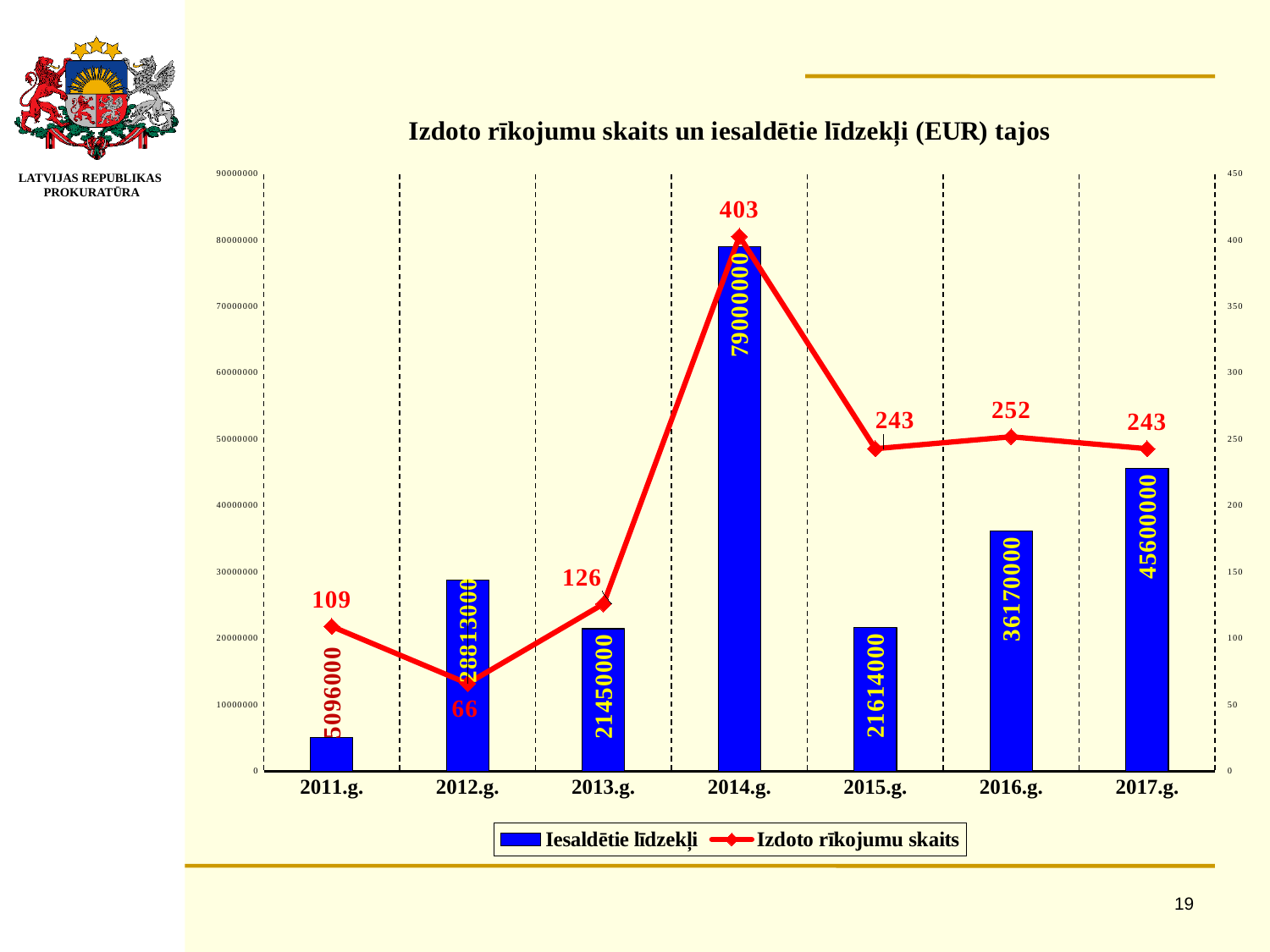
What is the difference between the Iesaldētie līdzekļi values for 2017.g. and 2016.g.? 9430000 What is the Izdoto rīkojumu skaits value for 2017.g.? 243 What is the Izdoto rīkojumu skaits value for 2011.g.? 109 What is the difference between the Izdoto rīkojumu skaits values for 2016.g. and 2015.g.? 9 Which year has the highest Iesaldētie līdzekļi value? 2014.g. Is the Iesaldētie līdzekļi value for 2012.g. greater or less than 20000000? greater Which year has the lowest Izdoto rīkojumu skaits value? 2012.g. Which year has a larger Iesaldētie līdzekļi value, 2016.g. or 2017.g.? 2017.g. How many series does the legend list? 2 What kind of chart is shown on the slide? Combined bar and line chart How many years are shown on the x axis of the chart? 7 What is the value of Iesaldētie līdzekļi for 2014.g.? 79000000